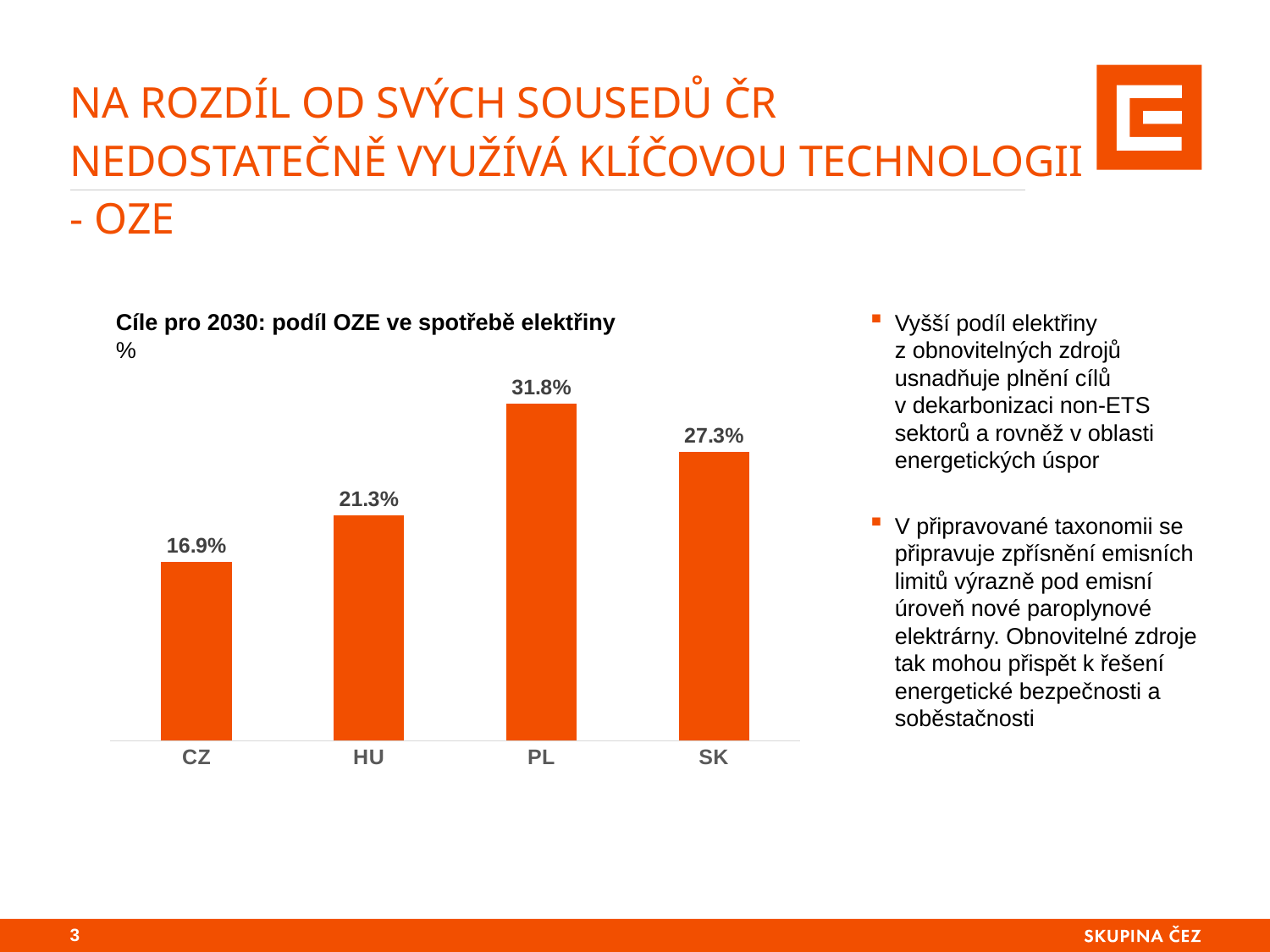
What is the difference between the values for SK and HU? 6.0% Which category has the lowest value? CZ What is the value for CZ? 16.9% What kind of chart is shown on the slide? Bar chart What is the value for SK? 27.3% How many categories are shown in the chart? 4 Which category has the highest value? PL What is the value for PL? 31.8% Which is larger, the value for HU or the value for SK? SK What is the difference between the values for PL and CZ? 14.9% What is the title of the chart? Cíle pro 2030: podíl OZE ve spotřebě elektřiny What unit is indicated below the chart title? %